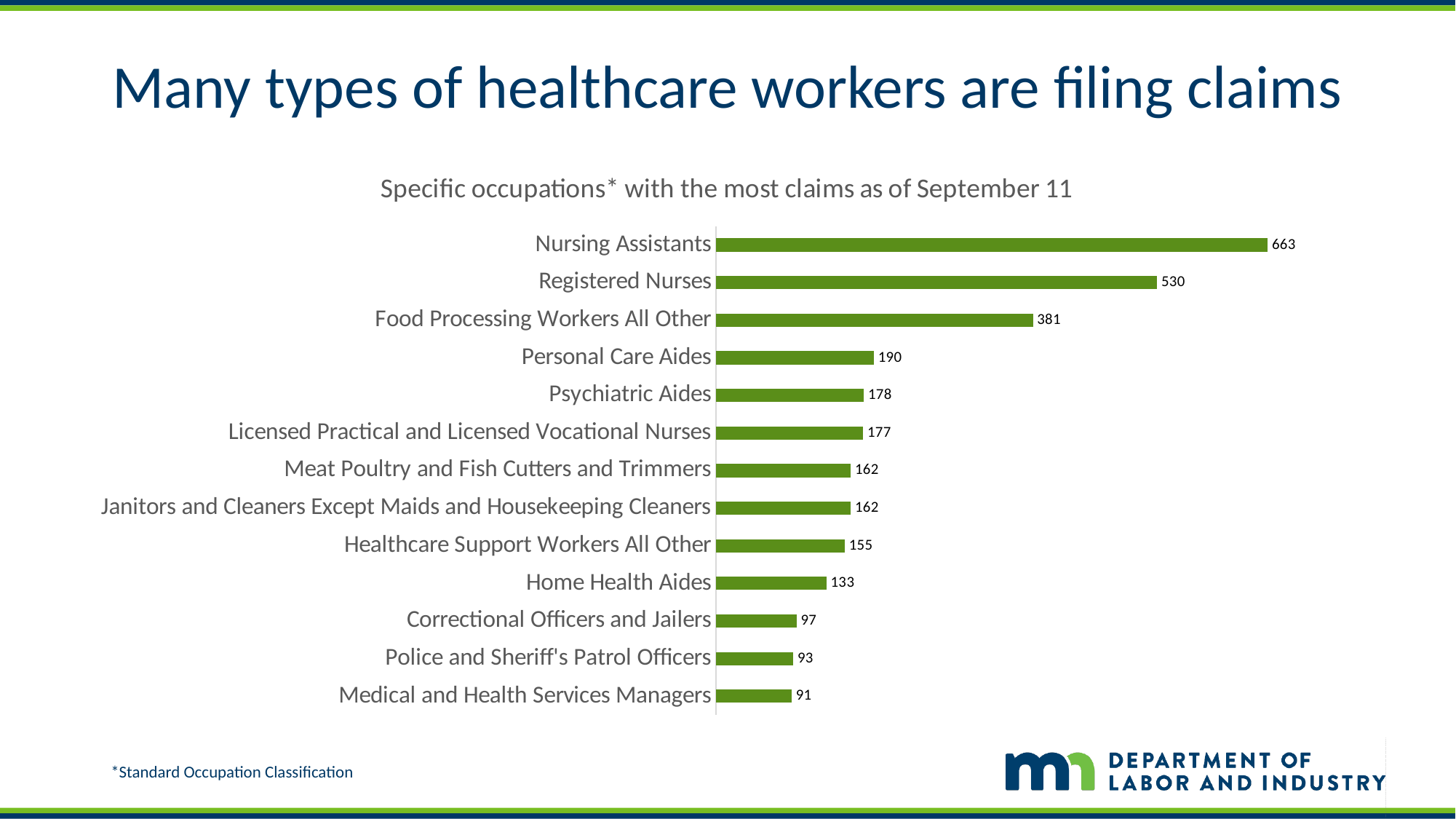
What is the value for Food Processing Workers All Other? 381 How many occupations are shown in the chart? 13 Which has more claims, Registered Nurses or Food Processing Workers All Other? Registered Nurses What is the difference between the values for Nursing Assistants and Registered Nurses? 133 What is the difference between the values for Personal Care Aides and Home Health Aides? 57 Which occupation has the fewest claims? Medical and Health Services Managers What is the value for Home Health Aides? 133 How many claims are shown for Nursing Assistants? 663 Which occupation has the most claims? Nursing Assistants Which has more claims, Correctional Officers and Jailers or Healthcare Support Workers All Other? Healthcare Support Workers All Other What kind of chart is shown on the slide? Bar chart What is the title of the chart? Specific occupations* with the most claims as of September 11